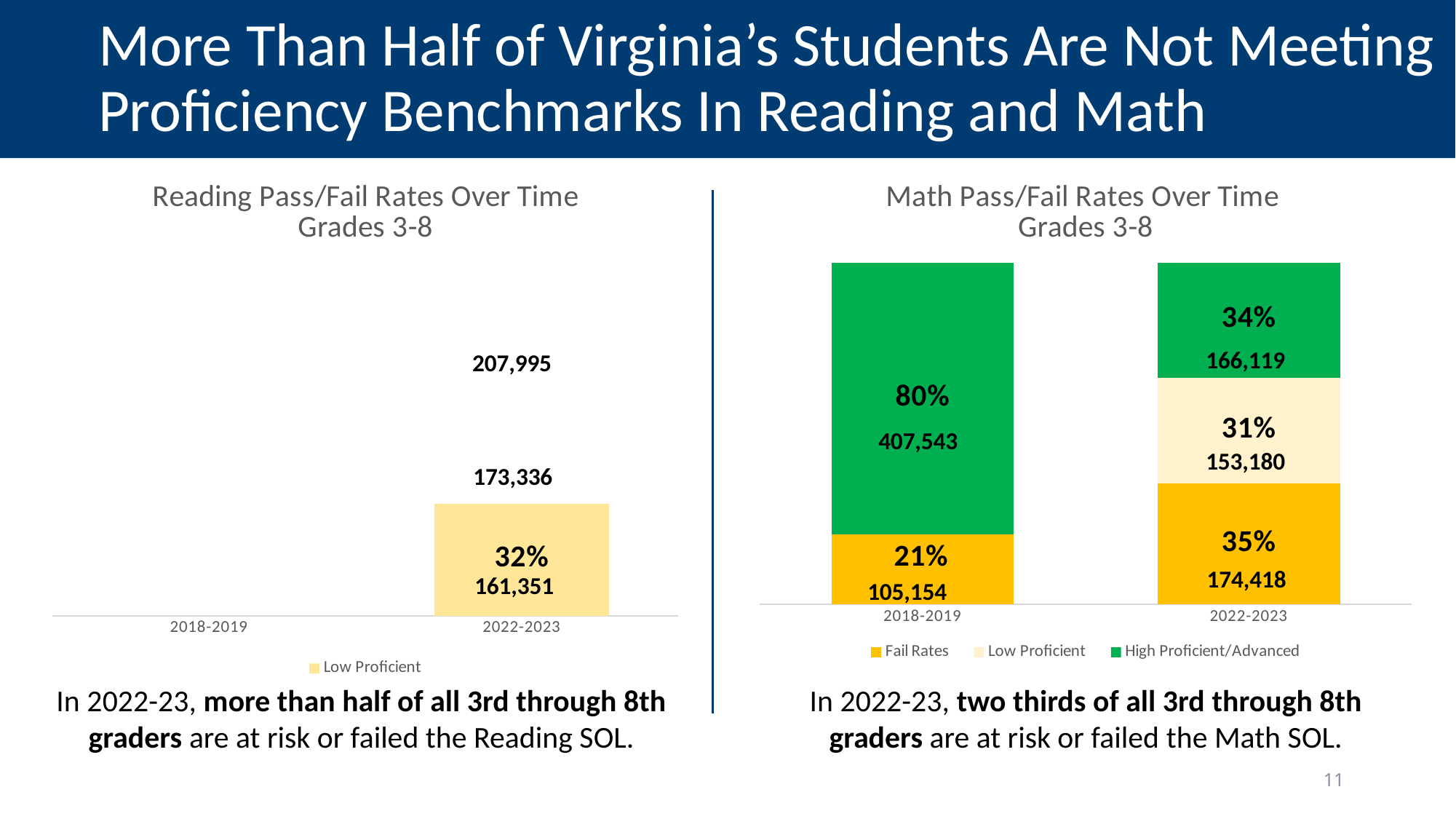
How many series does the legend of the Math Pass/Fail Rates Over Time chart list? 3 In the Math Pass/Fail Rates Over Time chart, what is the Fail Rates percentage for 2022-2023? 35% In the Math Pass/Fail Rates Over Time chart, what percentage of students were High Proficient/Advanced in 2018-2019? 80% In the Math Pass/Fail Rates Over Time chart, which year has the higher Fail Rates percentage, 2018-2019 or 2022-2023? 2022-2023 In the Math Pass/Fail Rates Over Time chart, by how many percentage points did the Fail Rates increase from 2018-2019 to 2022-2023? 14 percentage points In the Reading Pass/Fail Rates Over Time chart, what is the Low Proficient percentage for 2022-2023? 32% How many year categories are shown on the x axis of the Math Pass/Fail Rates Over Time chart? 2 In the Math Pass/Fail Rates Over Time chart, do the Fail Rates rise or fall from 2018-2019 to 2022-2023? Rise In the Math Pass/Fail Rates Over Time chart, how many students were High Proficient/Advanced in 2022-2023? 166,119 In the Math Pass/Fail Rates Over Time chart, how many students fell into Fail Rates in 2018-2019? 105,154 In the Math Pass/Fail Rates Over Time chart, how many students were Low Proficient in 2022-2023? 153,180 What kind of chart is the Math Pass/Fail Rates Over Time chart? Stacked bar chart